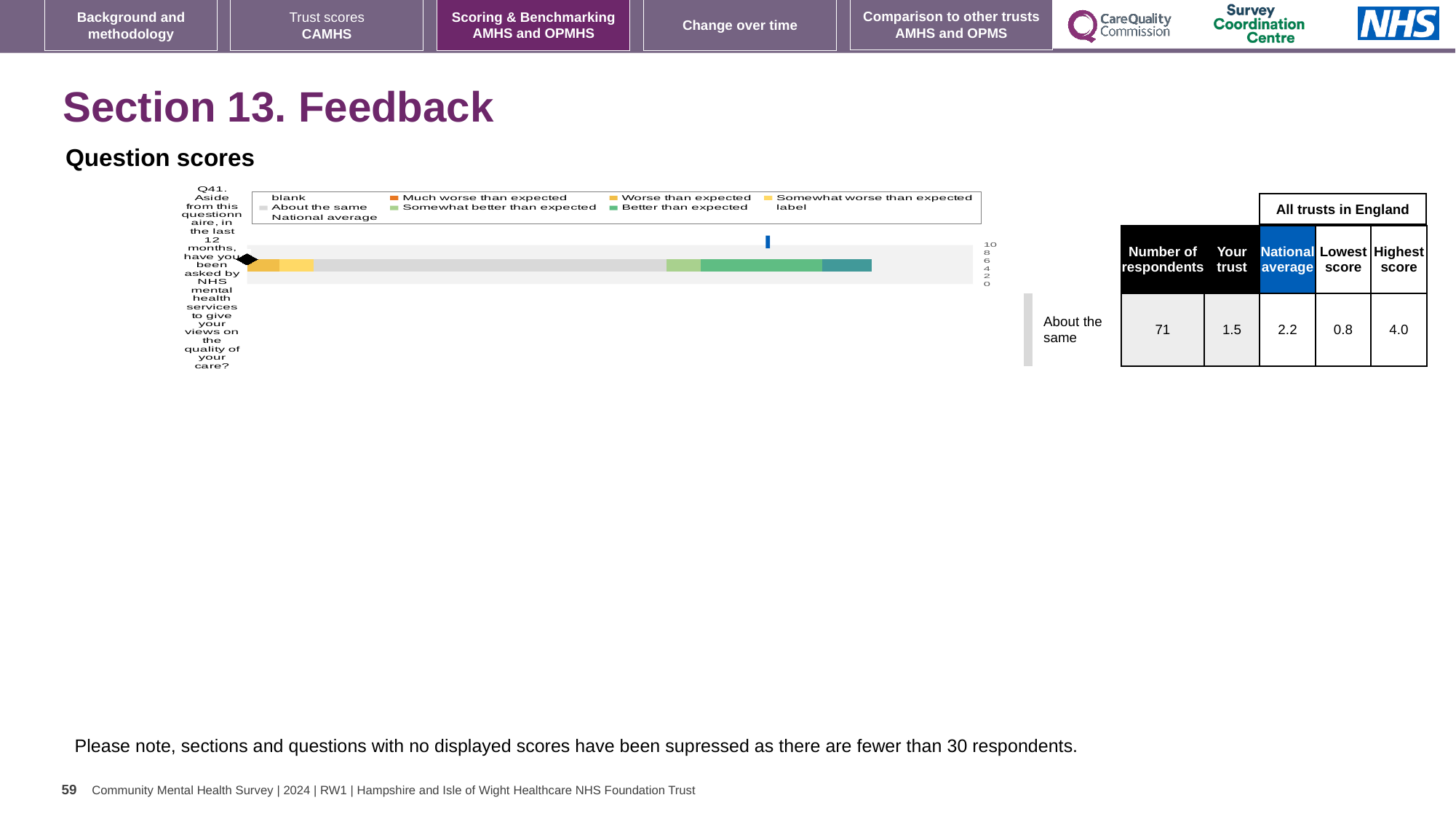
What is the highest tick value shown on the axis of the Question scores chart? 10 How many entries does the legend of the Question scores chart list? 9 In the table beside the chart, what is the number of respondents for Q41? 71 In the table beside the chart, what is the 'Your trust' score for Q41? 1.5 In the table beside the chart, which is larger for Q41: the 'Your trust' score or the national average? National average What kind of chart is shown under 'Question scores'? bar chart Which legend category occupies the largest segment of the Q41 bar? About the same In the table beside the chart, what is the difference between the highest score and the lowest score for Q41? 3.2 In the table beside the chart, what is the national average score for Q41? 2.2 What colour is the 'About the same' segment in the Question scores chart? grey Which question is plotted in the Question scores chart? Q41 How many questions (categories) are plotted in the Question scores chart? 1